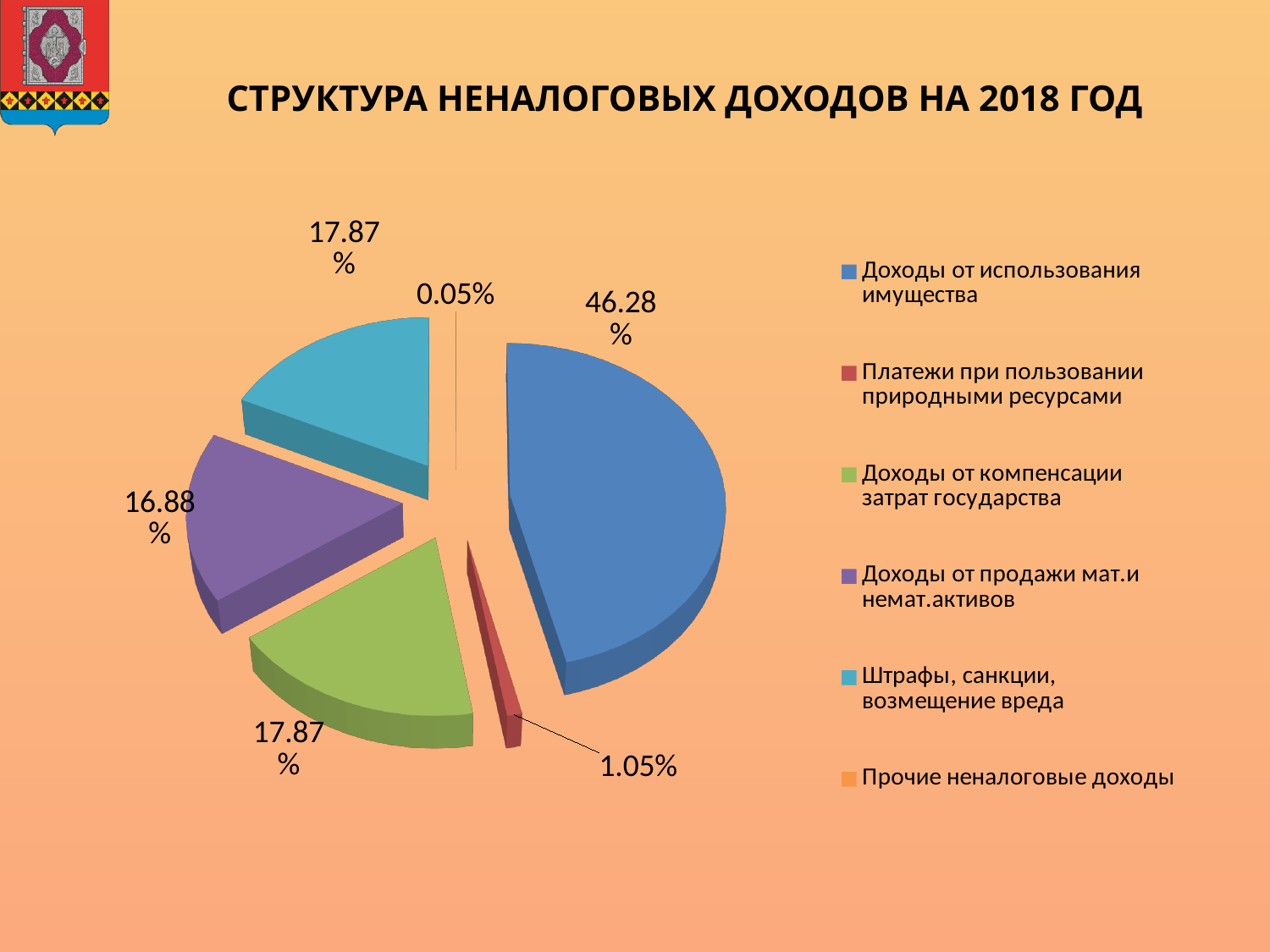
What is the difference between the share for "Доходы от использования имущества" and the share for "Доходы от продажи мат.и немат.активов"? 29.40% Which is larger: the share for "Доходы от компенсации затрат государства" or the share for "Платежи при пользовании природными ресурсами"? Доходы от компенсации затрат государства What share of the pie is labelled for "Прочие неналоговые доходы"? 0.05% What share of the pie is labelled for "Доходы от продажи мат.и немат.активов"? 16.88% What share of the pie is labelled for "Платежи при пользовании природными ресурсами"? 1.05% What share of the pie is labelled for "Доходы от использования имущества"? 46.28% What type of chart is shown on the slide? Pie chart What is the title of the chart on the slide? СТРУКТУРА НЕНАЛОГОВЫХ ДОХОДОВ НА 2018 ГОД How many categories does the legend of the pie chart list? 6 What share of the pie is labelled for "Штрафы, санкции, возмещение вреда"? 17.87% Which category has the largest share of the pie? Доходы от использования имущества Which category has the smallest share of the pie? Прочие неналоговые доходы